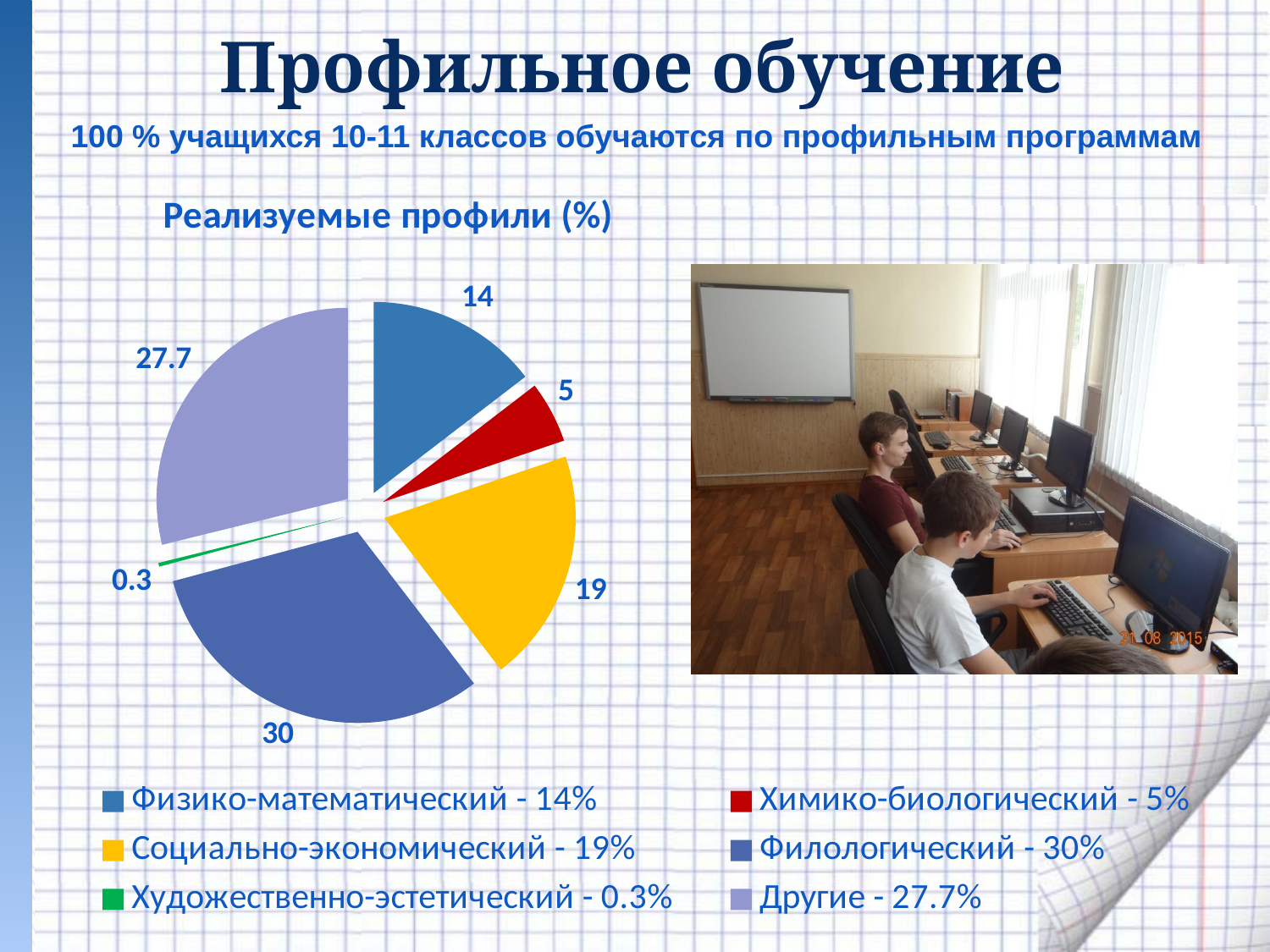
What is the value for Физико-математический? 14 What is the difference between the values for Филологический and Другие? 2.3 What is the title of the chart? Реализуемые профили (%) Which profile has the smallest share of the pie? Художественно-эстетический What type of chart is shown on the slide? pie chart What colour is the slice for Химико-биологический? red Which profile has the largest share of the pie? Филологический What is the value for Художественно-эстетический? 0.3 How many slices does the pie chart have? 6 What is the value for Социально-экономический? 19 What is the value for Химико-биологический? 5 Which is larger, the value for Социально-экономический or the value for Физико-математический? Социально-экономический